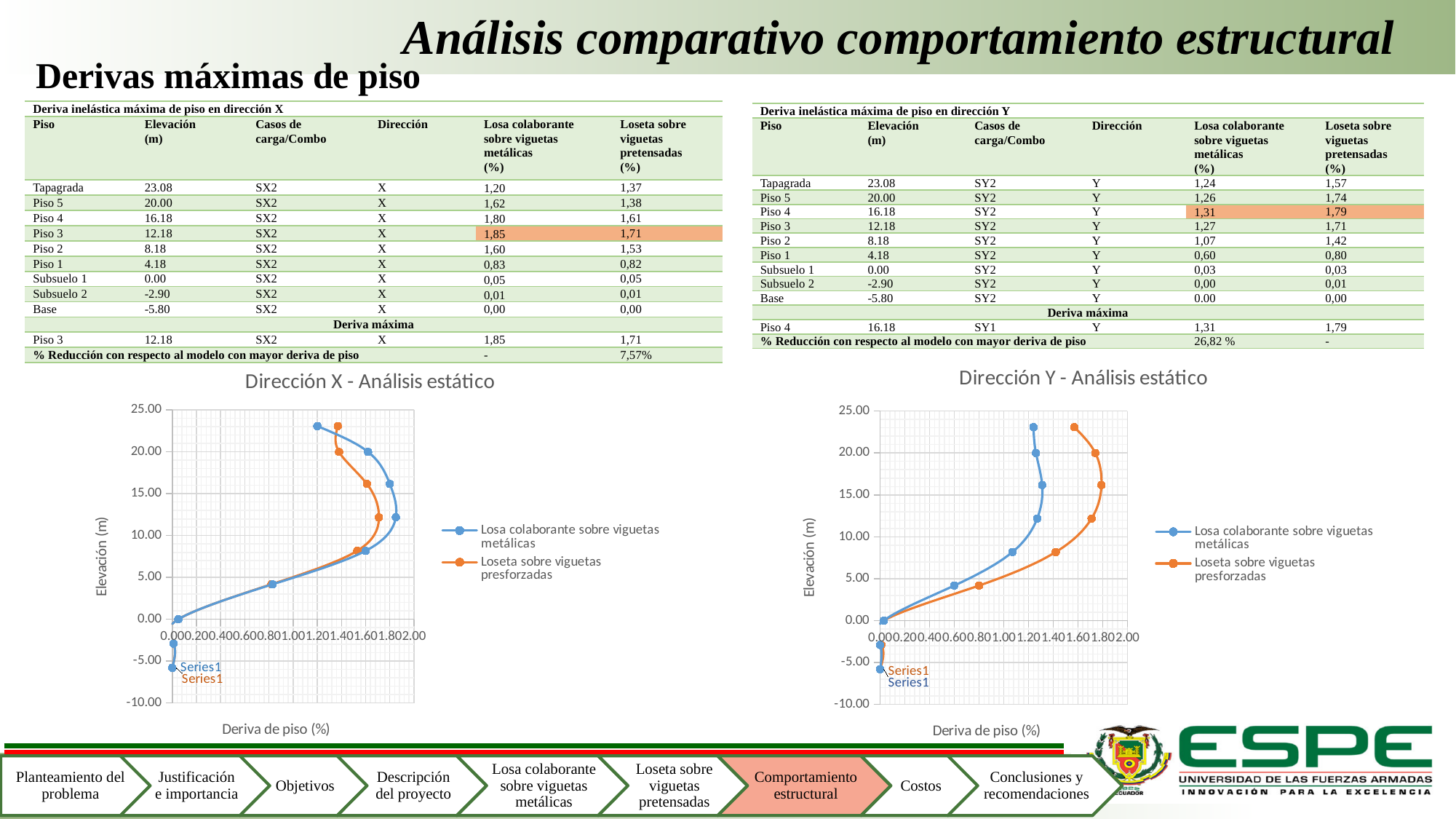
In the "Dirección Y - Análisis estático" chart, which series reaches the highest drift value overall? Loseta sobre viguetas presforzadas What is the horizontal axis title of the "Dirección Y - Análisis estático" chart? Deriva de piso (%) In the "Dirección X - Análisis estático" chart, does the drift of "Losa colaborante sobre viguetas metálicas" rise or fall as elevation increases from 0 m to about 12 m? rise In the "Dirección Y - Análisis estático" chart, which series shows the larger drift at about 20 m elevation? Loseta sobre viguetas presforzadas In the "Dirección Y - Análisis estático" chart, is the drift of "Losa colaborante sobre viguetas metálicas" at about 4 m elevation greater or less than 0.80? less What type of chart is "Dirección X - Análisis estático"? line chart In the "Dirección X - Análisis estático" chart, how many data points does the "Losa colaborante sobre viguetas metálicas" series have? 9 In the "Dirección X - Análisis estático" chart, is the drift value of "Loseta sobre viguetas presforzadas" at the topmost point greater or less than 1.20? greater In the "Dirección X - Análisis estático" chart, is the drift value of "Losa colaborante sobre viguetas metálicas" at the highest elevation point (about 23 m) greater or less than 1.40? less How many series does the legend of the "Dirección Y - Análisis estático" chart list? 2 In the "Dirección X - Análisis estático" chart, which series shows the larger drift at the topmost point (about 23 m)? Loseta sobre viguetas presforzadas